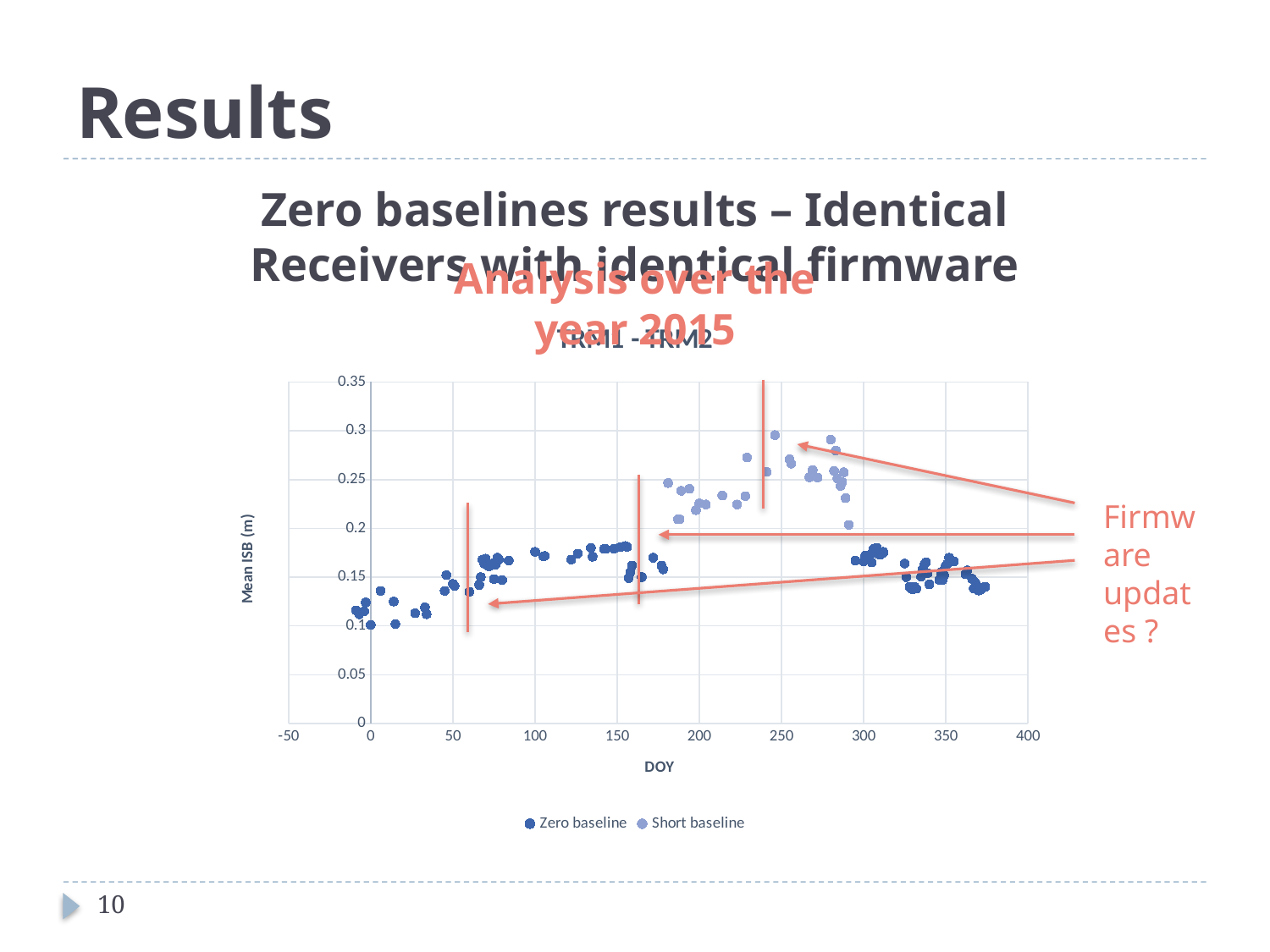
Is the highest Short baseline point, near DOY 250, greater or less than 0.25? greater What are the two series named in the chart's legend? Zero baseline and Short baseline Do the Short baseline values rise or fall between DOY 200 and DOY 250? rise How many series does the chart's legend list? 2 Are the Zero baseline values near DOY 0 greater or less than 0.15? less Which series contains the highest plotted Mean ISB value? Short baseline What is the label of the chart's vertical axis? Mean ISB (m) Do the Zero baseline values rise or fall between DOY 0 and DOY 150? rise Which series contains the lowest plotted Mean ISB value? Zero baseline Which series has the higher Mean ISB values overall, Zero baseline or Short baseline? Short baseline Are the Zero baseline values greater or less than 0.2 on the Mean ISB axis? less What kind of chart is shown on the slide? Scatter chart